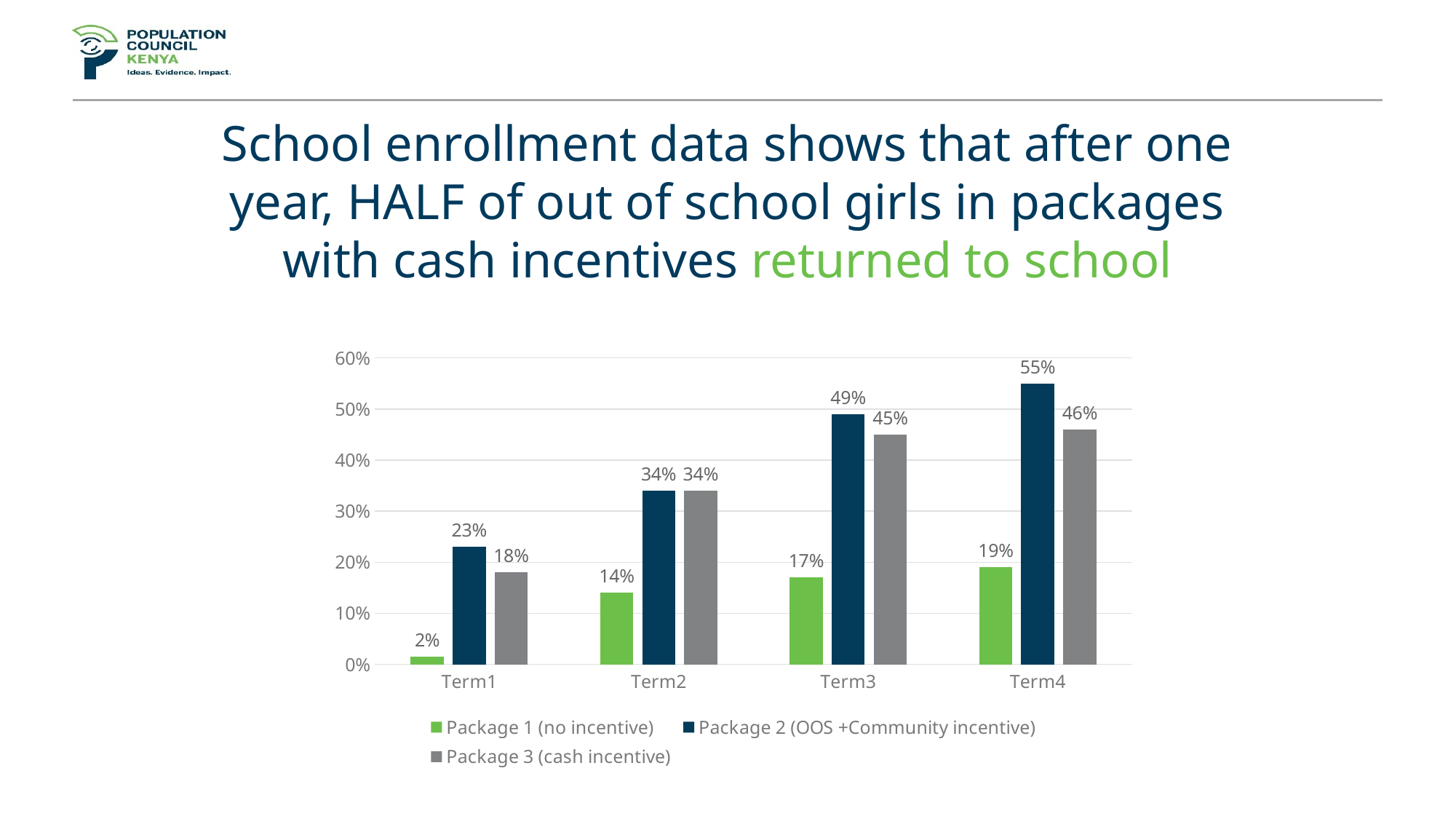
What is the value for Package 3 (cash incentive) in Term3? 45% Which is larger in Term1: Package 2 (OOS +Community incentive) or Package 3 (cash incentive)? Package 2 (OOS +Community incentive) How many series does the legend list? 3 What kind of chart is shown on the slide? bar chart Which term has the highest value for Package 2 (OOS +Community incentive)? Term4 How many terms are shown on the x axis? 4 Do the values for Package 2 (OOS +Community incentive) rise or fall from Term1 to Term4? rise Is the value for Package 3 (cash incentive) in Term4 greater or less than 40%? greater Which term has the lowest value for Package 1 (no incentive)? Term1 What is the value for Package 2 (OOS +Community incentive) in Term4? 55% What is the difference between Package 2 (OOS +Community incentive) and Package 1 (no incentive) in Term4? 36% What is the value for Package 1 (no incentive) in Term1? 2%